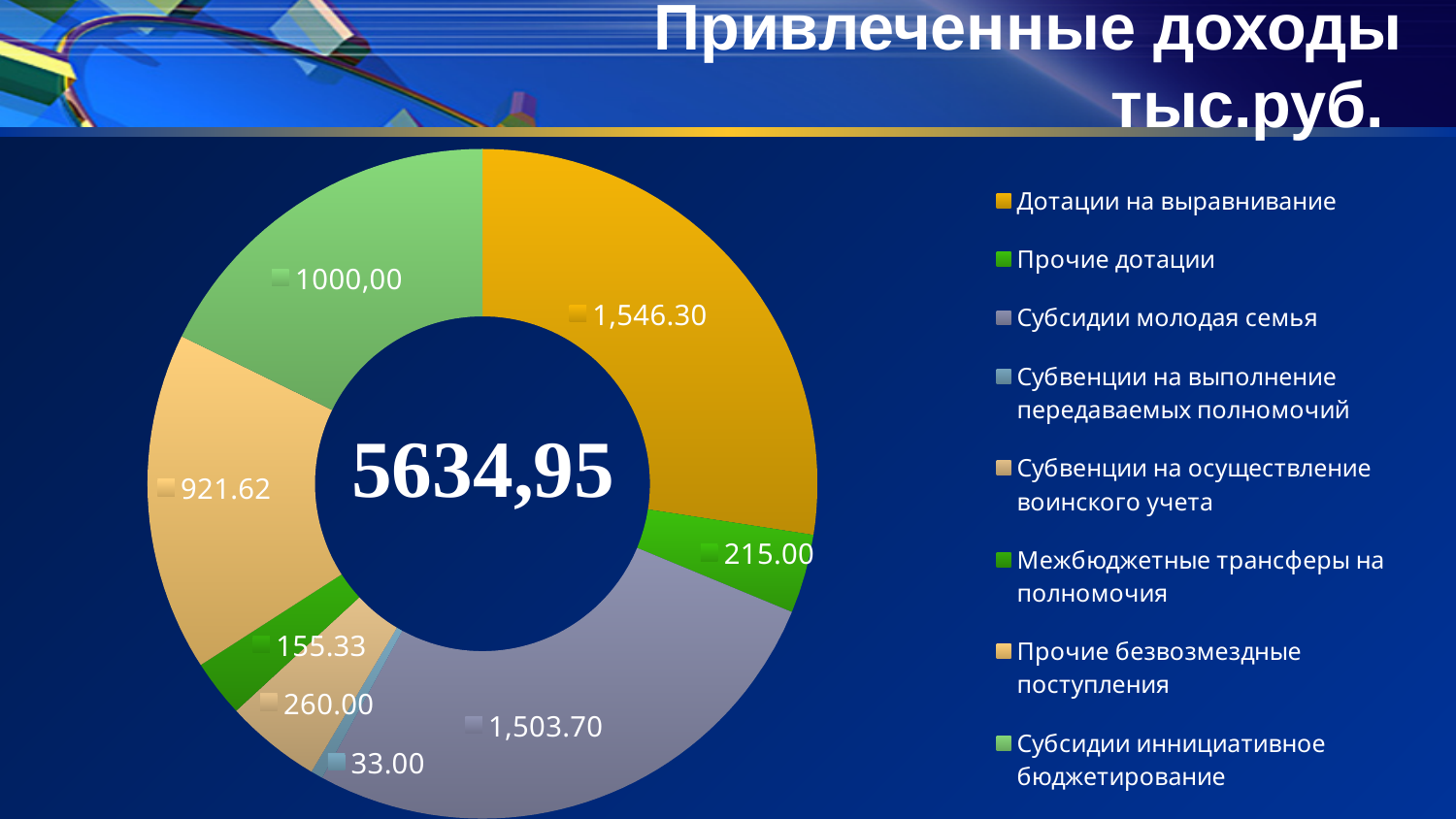
What is the difference between the values for Дотации на выравнивание and Субсидии молодая семья? 42.60 What is the value for Прочие безвозмездные поступления? 921.62 What total value is printed in the centre of the chart? 5634,95 How many categories does the legend list? 8 What is the value for Дотации на выравнивание? 1,546.30 What is the value for Субсидии молодая семья? 1,503.70 Which category has the largest value? Дотации на выравнивание What kind of chart is shown on the slide? doughnut (pie) chart Which is larger: Прочие дотации or Межбюджетные трансферы на полномочия? Прочие дотации What is the title of the slide? Привлеченные доходы тыс.руб. Which category has the smallest value? Субвенции на выполнение передаваемых полномочий What is the value for Субвенции на осуществление воинского учета? 260.00